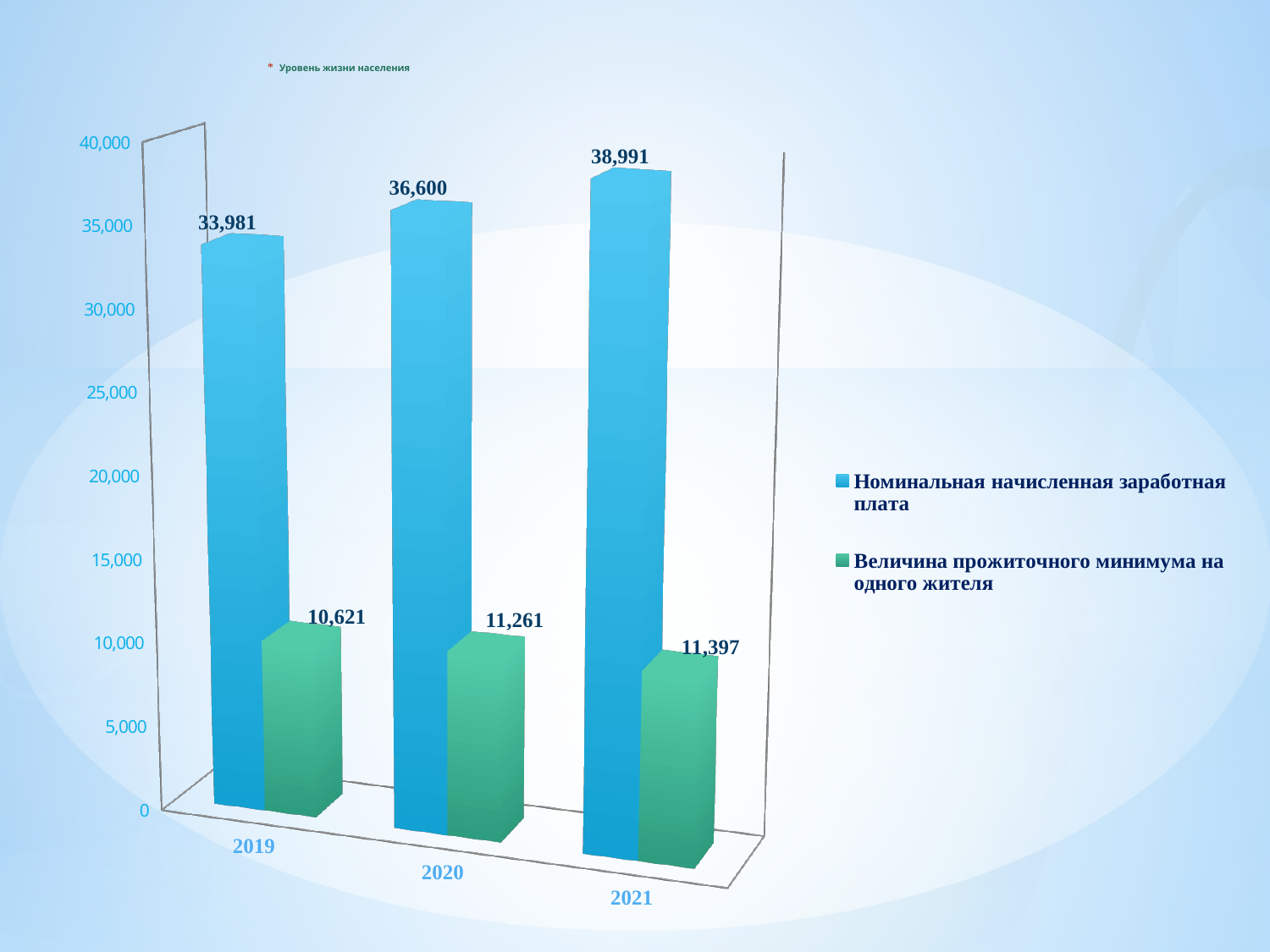
What kind of chart is shown on the slide? bar chart Which is larger: Номинальная начисленная заработная плата in 2019 or in 2020? 2020 What is the difference between Номинальная начисленная заработная плата in 2021 and in 2019? 5,010 Does Номинальная начисленная заработная плата rise or fall from 2019 to 2021? rise How many series does the legend list? 2 What is the value of Величина прожиточного минимума на одного жителя for 2021? 11,397 In which year is Величина прожиточного минимума на одного жителя lowest? 2019 What is the value of Номинальная начисленная заработная плата for 2020? 36,600 How many years are shown on the x axis? 3 What is the difference between Величина прожиточного минимума на одного жителя in 2020 and in 2019? 640 In which year is Номинальная начисленная заработная плата highest? 2021 What is the value of Величина прожиточного минимума на одного жителя for 2019? 10,621